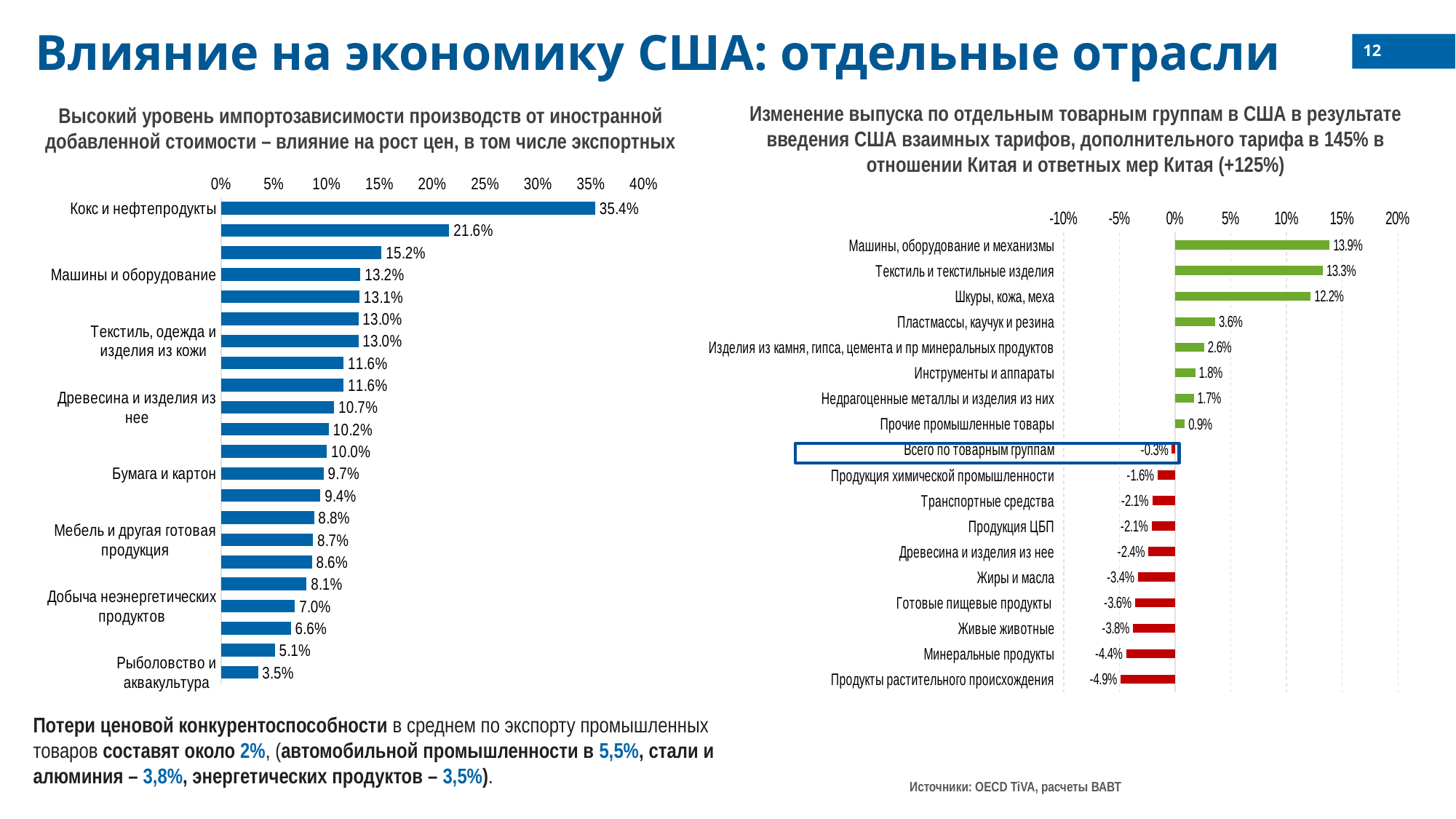
On the right chart, how many categories are plotted? 18 What type of chart is shown on the right side of the slide? Bar chart On the right chart, which category has the lowest value? Продукты растительного происхождения On the left chart, what is the value for Рыболовство и аквакультура? 3.5% On the left chart, what is the difference between Кокс и нефтепродукты and Рыболовство и аквакультура? 31.9% On the right chart, what is the value for Машины, оборудование и механизмы? 13.9% On the right chart, which is larger: Текстиль и текстильные изделия or Шкуры, кожа, меха? Текстиль и текстильные изделия On the right chart, what is the difference between Пластмассы, каучук и резина and Жиры и масла? 7.0% On the left chart, what is the value for Кокс и нефтепродукты? 35.4% On the left chart, which labelled category has the highest value? Кокс и нефтепродукты On the right chart, what is the value for Всего по товарным группам? -0.3% On the left chart, what is the value for Бумага и картон? 9.7%